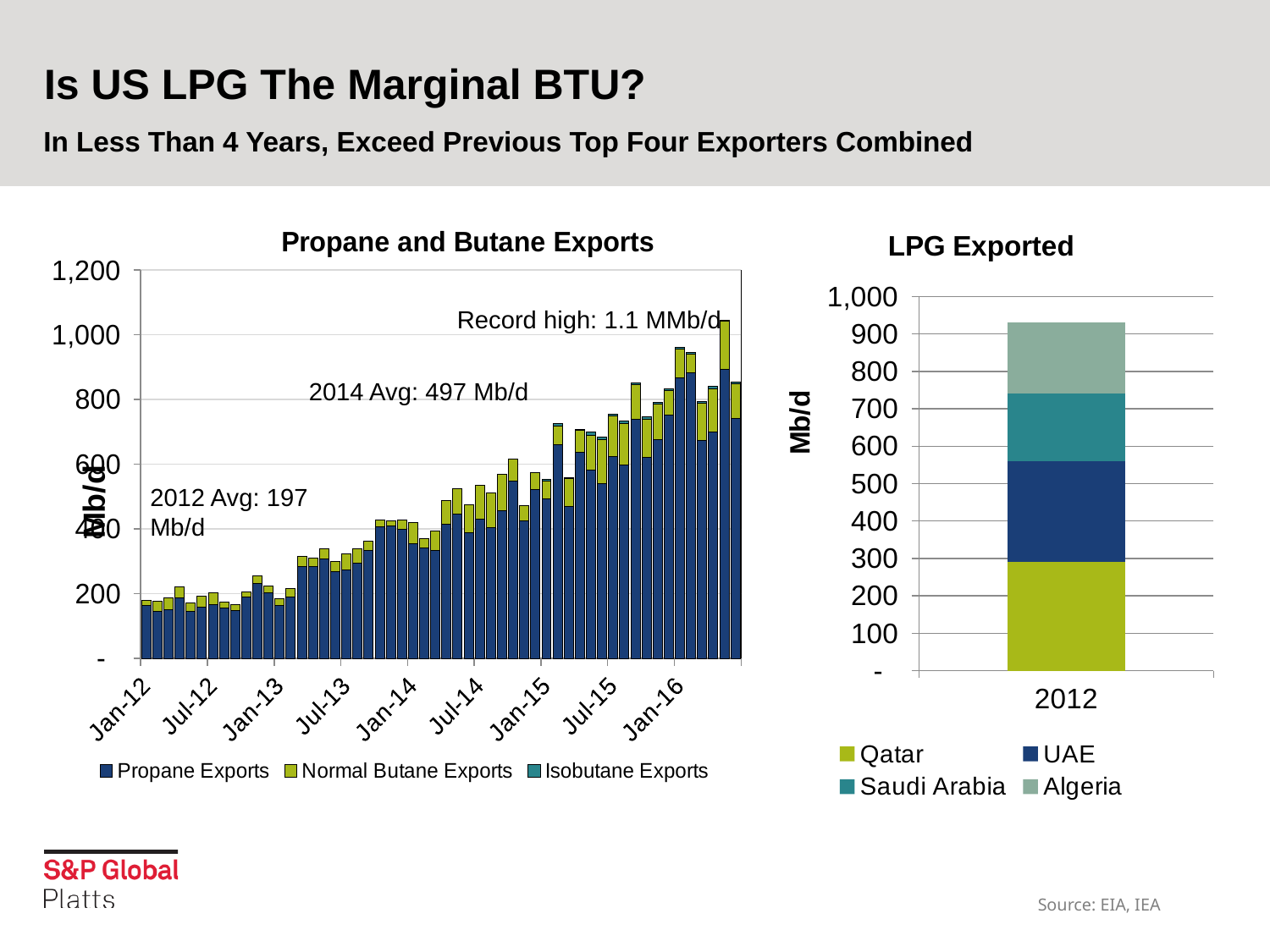
According to the annotation on the 'Propane and Butane Exports' chart, what was the 2012 average? 197 Mb/d In the 'Propane and Butane Exports' chart, do the total exports rise or fall from Jan-12 to Jan-16? Rise According to the annotation on the 'Propane and Butane Exports' chart, what is the record high? 1.1 MMb/d How many series does the legend of the 'Propane and Butane Exports' chart list? 3 How many series does the legend of the 'LPG Exported' chart list? 4 What kind of chart is the 'Propane and Butane Exports' chart? Bar chart How many categories are shown on the x axis of the 'LPG Exported' chart? 1 What is the y-axis label on the 'LPG Exported' chart? Mb/d In the 'LPG Exported' chart, is the total height of the 2012 bar greater or less than 900? greater In the 'LPG Exported' chart, which is larger for 2012, the Qatar segment or the Saudi Arabia segment? Qatar In the 'Propane and Butane Exports' chart, which series makes up the largest part of each bar? Propane Exports According to the annotation on the 'Propane and Butane Exports' chart, what was the 2014 average? 497 Mb/d